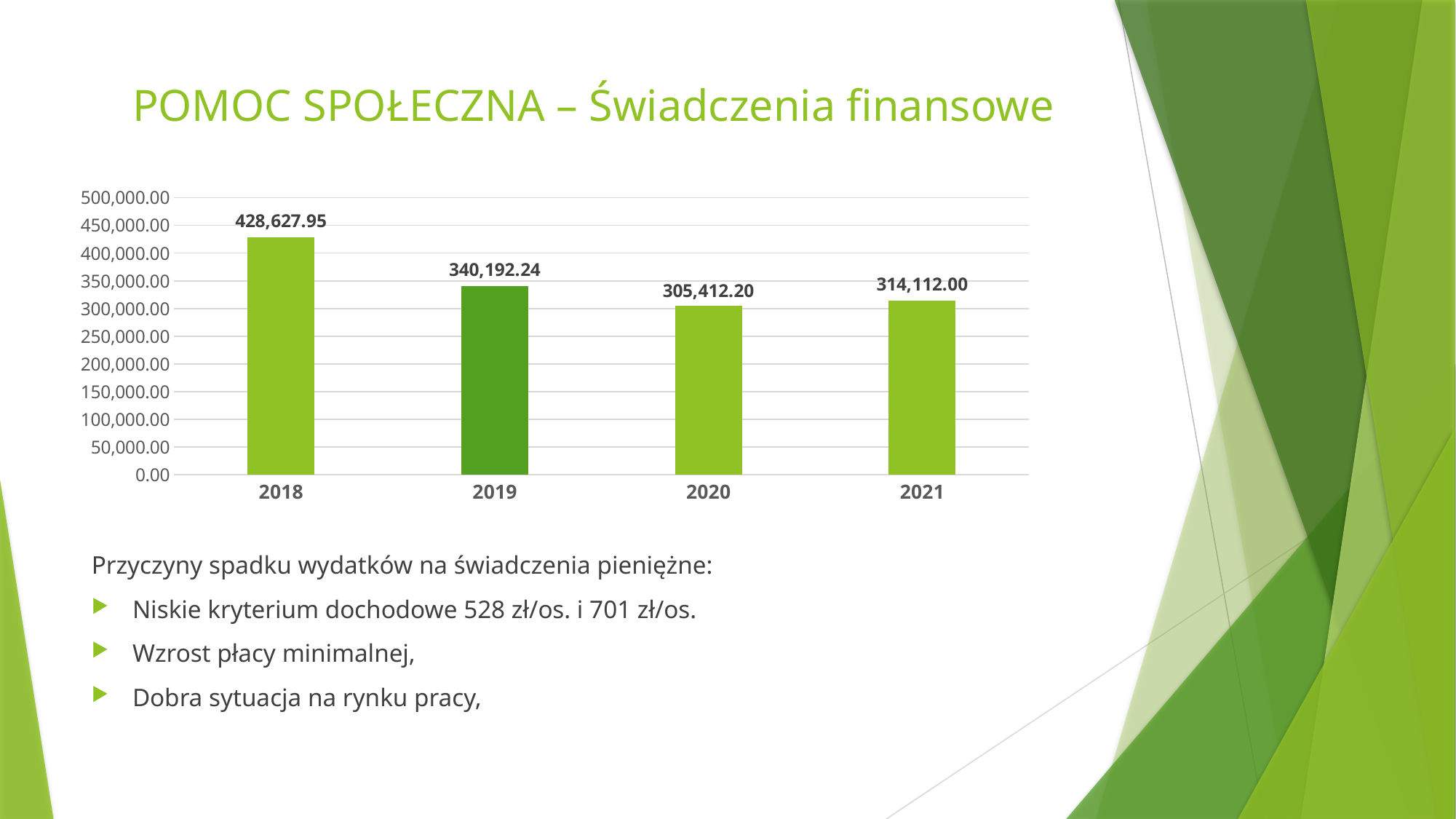
What is the difference between the values for 2021 and 2020? 8,699.80 Which is larger, the value for 2019 or the value for 2021? 2019 Which year has the lowest value? 2020 What is the value for 2020? 305,412.20 What kind of chart is shown on the slide? bar chart What is the value for 2018? 428,627.95 How many years are shown on the chart? 4 What is the value for 2021? 314,112.00 What is the value for 2019? 340,192.24 Which year has the highest value? 2018 Is the value for 2020 greater or less than 350,000.00? less What is the difference between the values for 2018 and 2019? 88,435.71